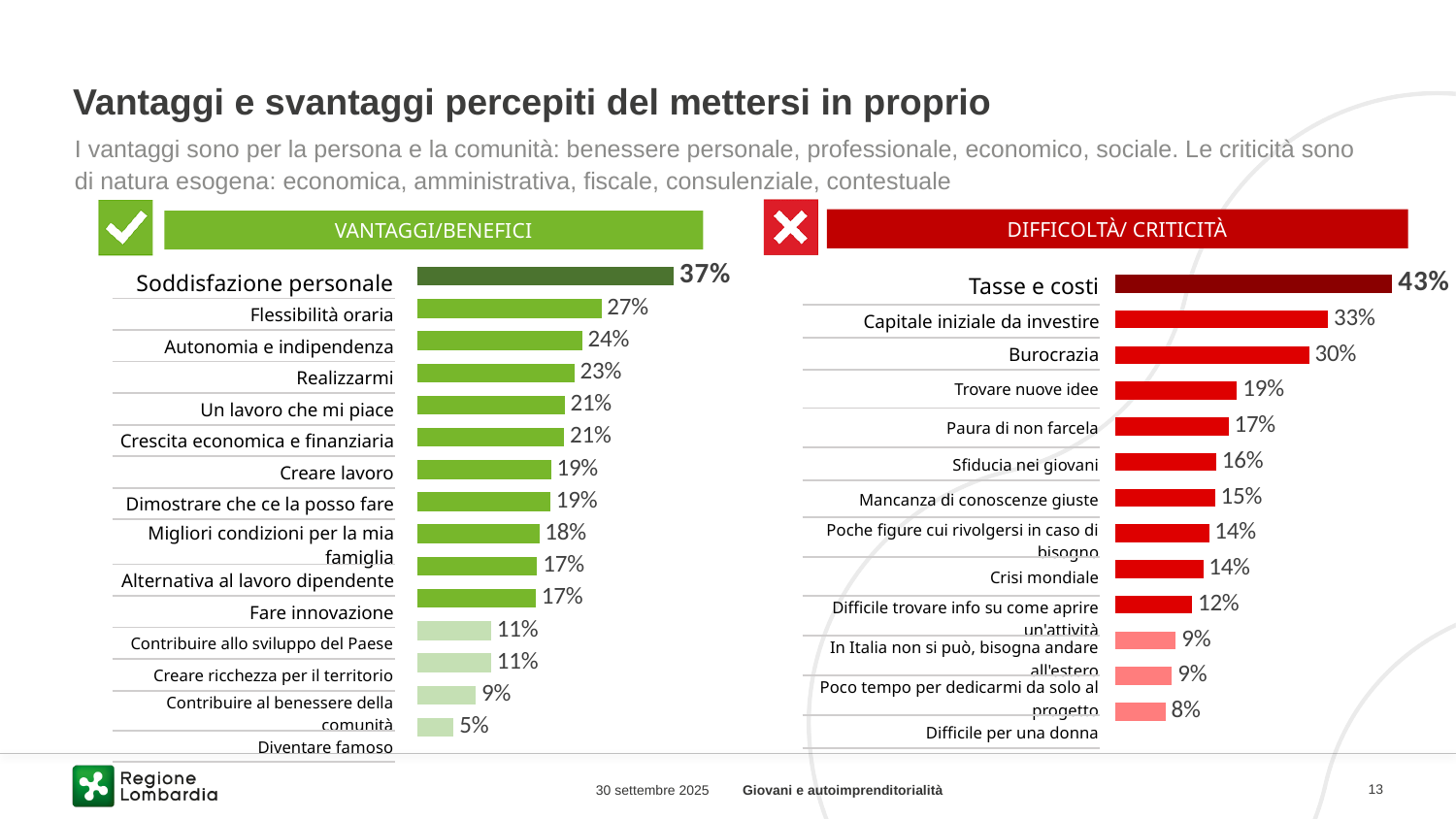
In the VANTAGGI/BENEFICI chart, how many categories are shown? 15 In the DIFFICOLTÀ/ CRITICITÀ chart, what is the value for Burocrazia? 30% In the DIFFICOLTÀ/ CRITICITÀ chart, which category has the highest value? Tasse e costi In the VANTAGGI/BENEFICI chart, what is the value for Flessibilità oraria? 27% In the VANTAGGI/BENEFICI chart, what is the difference between Soddisfazione personale and Autonomia e indipendenza? 13% In the DIFFICOLTÀ/ CRITICITÀ chart, how many categories are shown? 13 In the DIFFICOLTÀ/ CRITICITÀ chart, which is larger: Capitale iniziale da investire or Trovare nuove idee? Capitale iniziale da investire In the VANTAGGI/BENEFICI chart, what is the value for Soddisfazione personale? 37% In the VANTAGGI/BENEFICI chart, which category has the lowest value? Diventare famoso In the DIFFICOLTÀ/ CRITICITÀ chart, what is the difference between Tasse e costi and Capitale iniziale da investire? 10% What type of chart is the VANTAGGI/BENEFICI chart? Bar chart In the DIFFICOLTÀ/ CRITICITÀ chart, what is the value for Tasse e costi? 43%